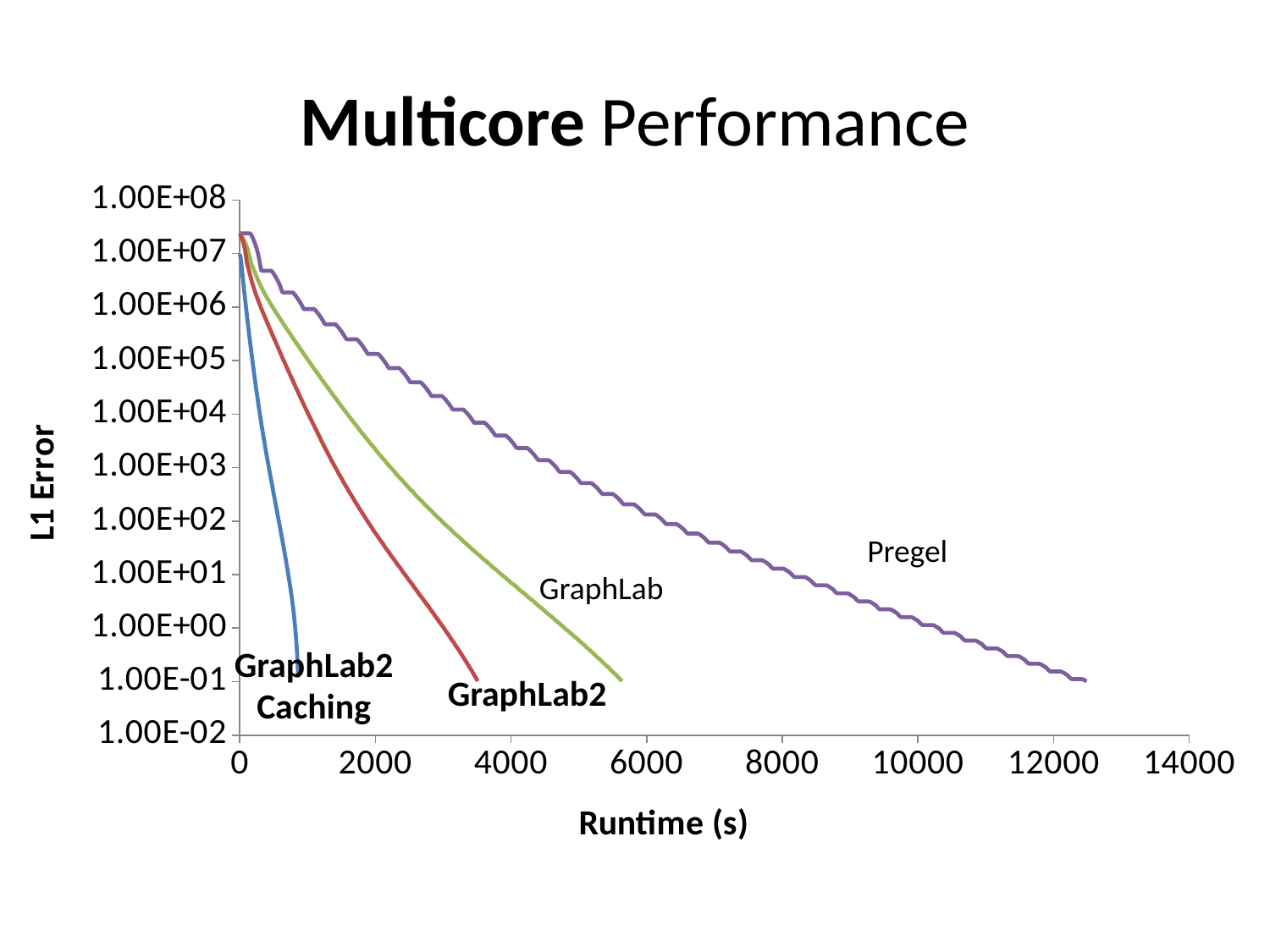
Is the runtime at which the GraphLab2 line ends greater or less than 4000 s? less Is the runtime at which the GraphLab2 Caching line ends greater or less than 2000 s? less Which series reaches an L1 Error of 1.00E-01 sooner, GraphLab2 or GraphLab? GraphLab2 Which series takes the longest runtime to reach the bottom of its curve? Pregel What is the title of the chart? Multicore Performance What is the label of the y axis? L1 Error Does the L1 Error rise or fall as Runtime increases for each series? fall Is the runtime at which the GraphLab line ends greater or less than 6000 s? less What kind of chart is shown on the slide? line chart Which series reaches the bottom of its curve in the shortest runtime? GraphLab2 Caching How many lines (series) are plotted on the chart? 4